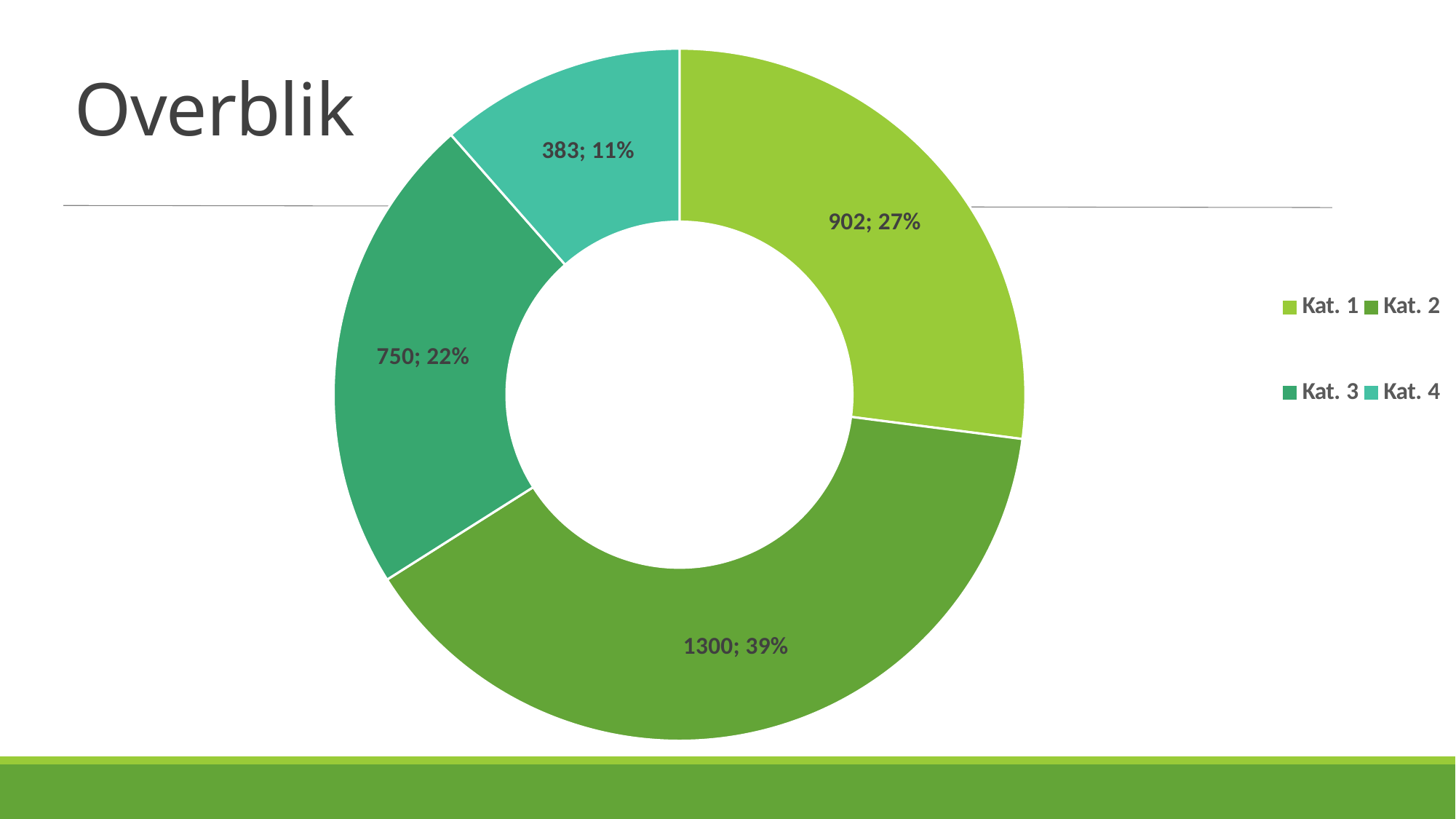
What is the value for Kat. 1? 902 Which category has the largest slice? Kat. 2 What share of the chart does Kat. 4 represent? 11% What share of the chart does Kat. 3 represent? 22% What is the difference between the values for Kat. 2 and Kat. 1? 398 Which category has the smallest slice? Kat. 4 What is the value for Kat. 3? 750 What is the value for Kat. 2? 1300 Which is larger, the value for Kat. 3 or the value for Kat. 4? Kat. 3 What is the value for Kat. 4? 383 How many categories are shown in the chart? 4 What kind of chart is shown on the slide? Doughnut chart